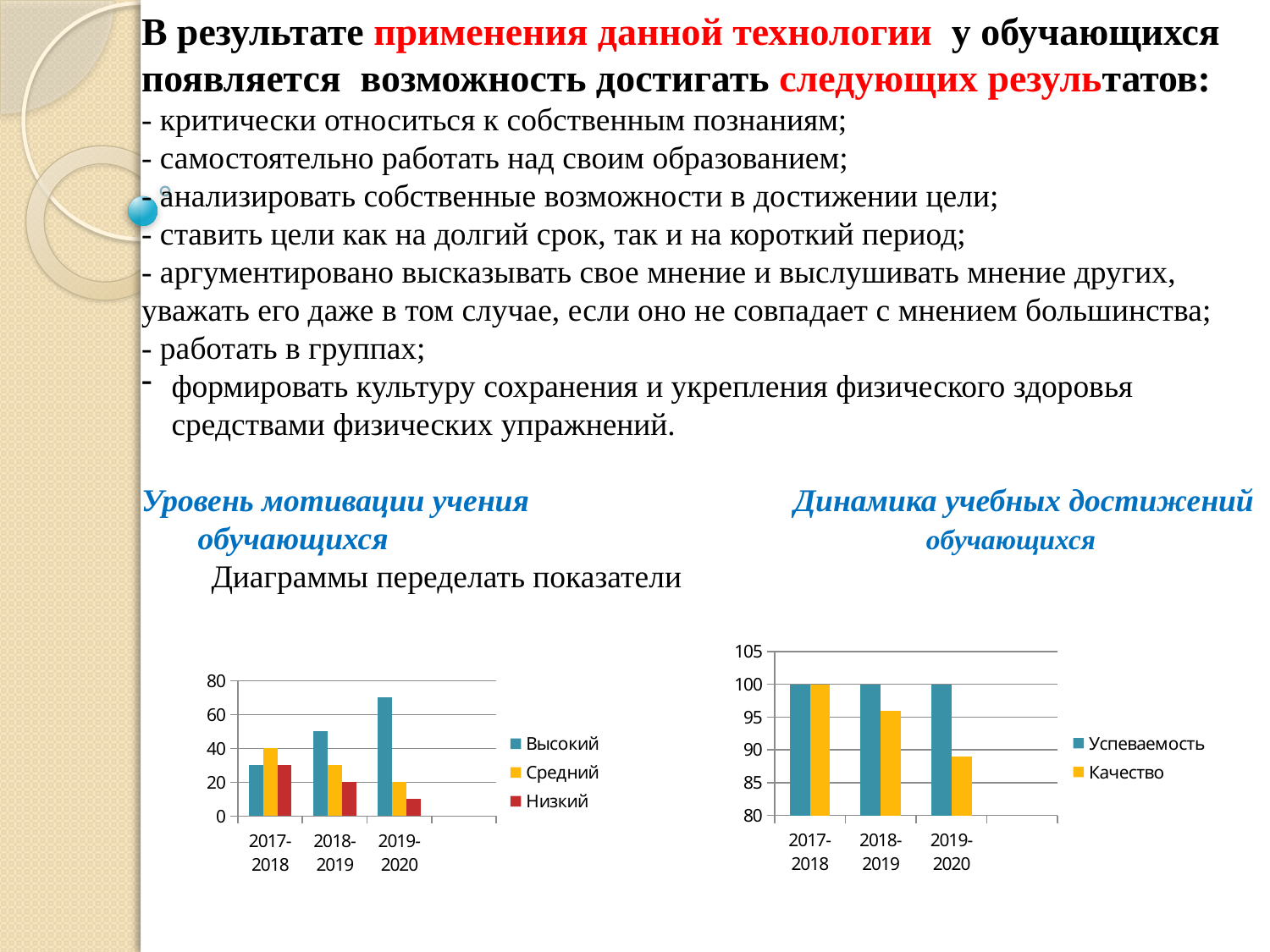
What are the two legend entries of the right chart 'Динамика учебных достижений обучающихся'? Успеваемость and Качество In the right chart 'Динамика учебных достижений обучающихся', is the value of 'Качество' for 2019-2020 greater or less than 90? less In the left chart 'Уровень мотивации учения обучающихся', which year has the highest value for 'Высокий'? 2019-2020 In the left chart 'Уровень мотивации учения обучающихся', is the value of 'Высокий' for 2019-2020 greater or less than 60? greater In the right chart 'Динамика учебных достижений обучающихся', what is the value of 'Успеваемость' for 2019-2020? 100 In the left chart 'Уровень мотивации учения обучающихся', does the 'Низкий' series rise or fall from 2017-2018 to 2019-2020? fall In the right chart 'Динамика учебных достижений обучающихся', which is larger for 2018-2019: 'Успеваемость' or 'Качество'? Успеваемость How many categories are shown on the x axis of the right chart 'Динамика учебных достижений обучающихся'? 3 How many series does the legend of the left chart 'Уровень мотивации учения обучающихся' list? 3 What kind of chart is the left chart titled 'Уровень мотивации учения обучающихся'? bar chart In the left chart 'Уровень мотивации учения обучающихся', does the 'Высокий' series rise or fall from 2017-2018 to 2019-2020? rise In the left chart 'Уровень мотивации учения обучающихся', what is the value of 'Средний' for 2017-2018? 40